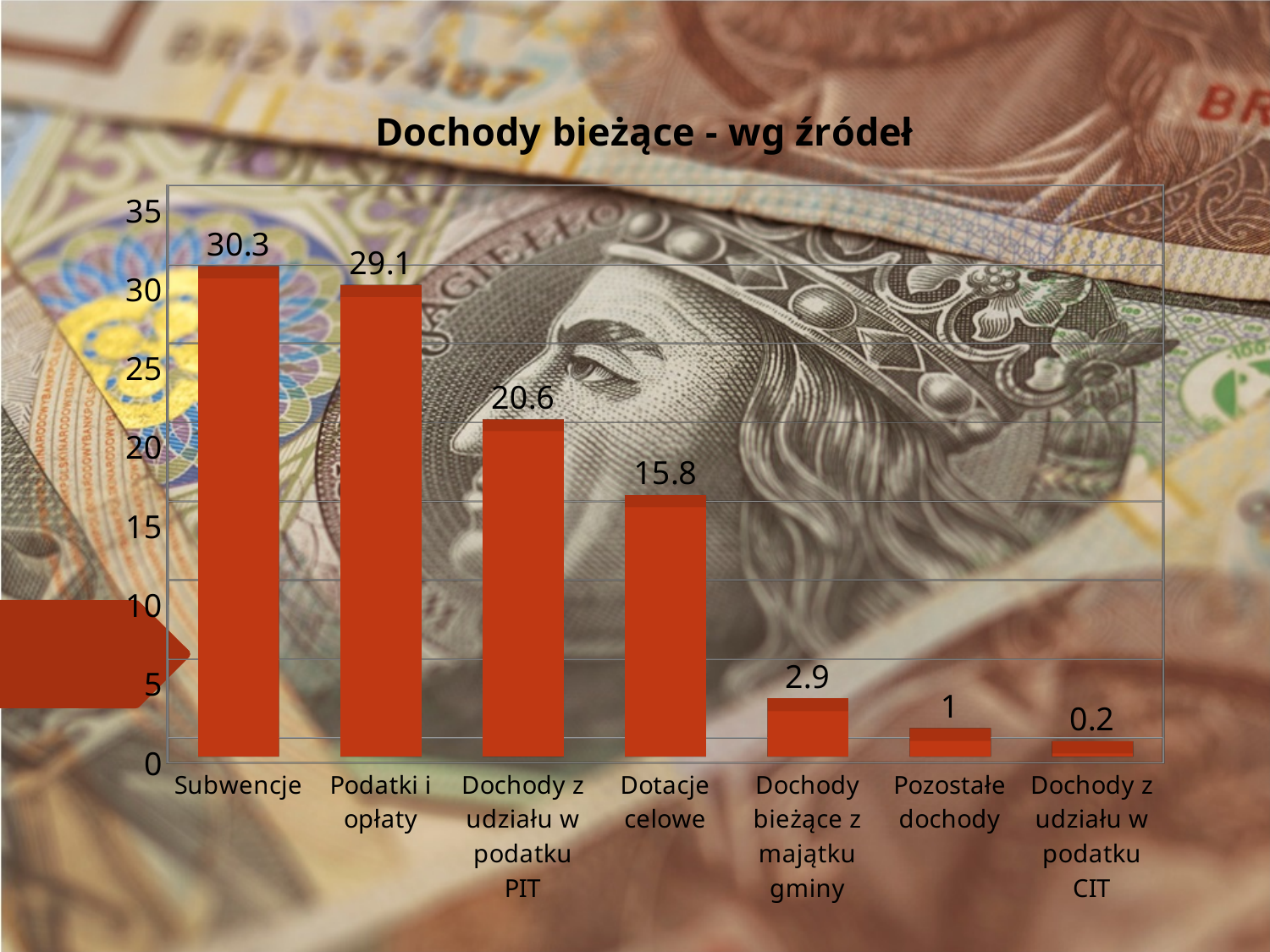
What is the title of the chart? Dochody bieżące - wg źródeł How many categories are shown on the chart? 7 What is the difference between the values for Subwencje and Podatki i opłaty? 1.2 What is the value for Dochody z udziału w podatku CIT? 0.2 Which is larger, the value for Dochody bieżące z majątku gminy or the value for Pozostałe dochody? Dochody bieżące z majątku gminy Which category has the highest value? Subwencje What kind of chart is shown on the slide? bar chart What is the value for Subwencje? 30.3 What is the value for Dotacje celowe? 15.8 Which category has the lowest value? Dochody z udziału w podatku CIT Is the value for Dochody z udziału w podatku PIT greater or less than 20? greater What is the difference between the values for Dochody z udziału w podatku PIT and Dotacje celowe? 4.8